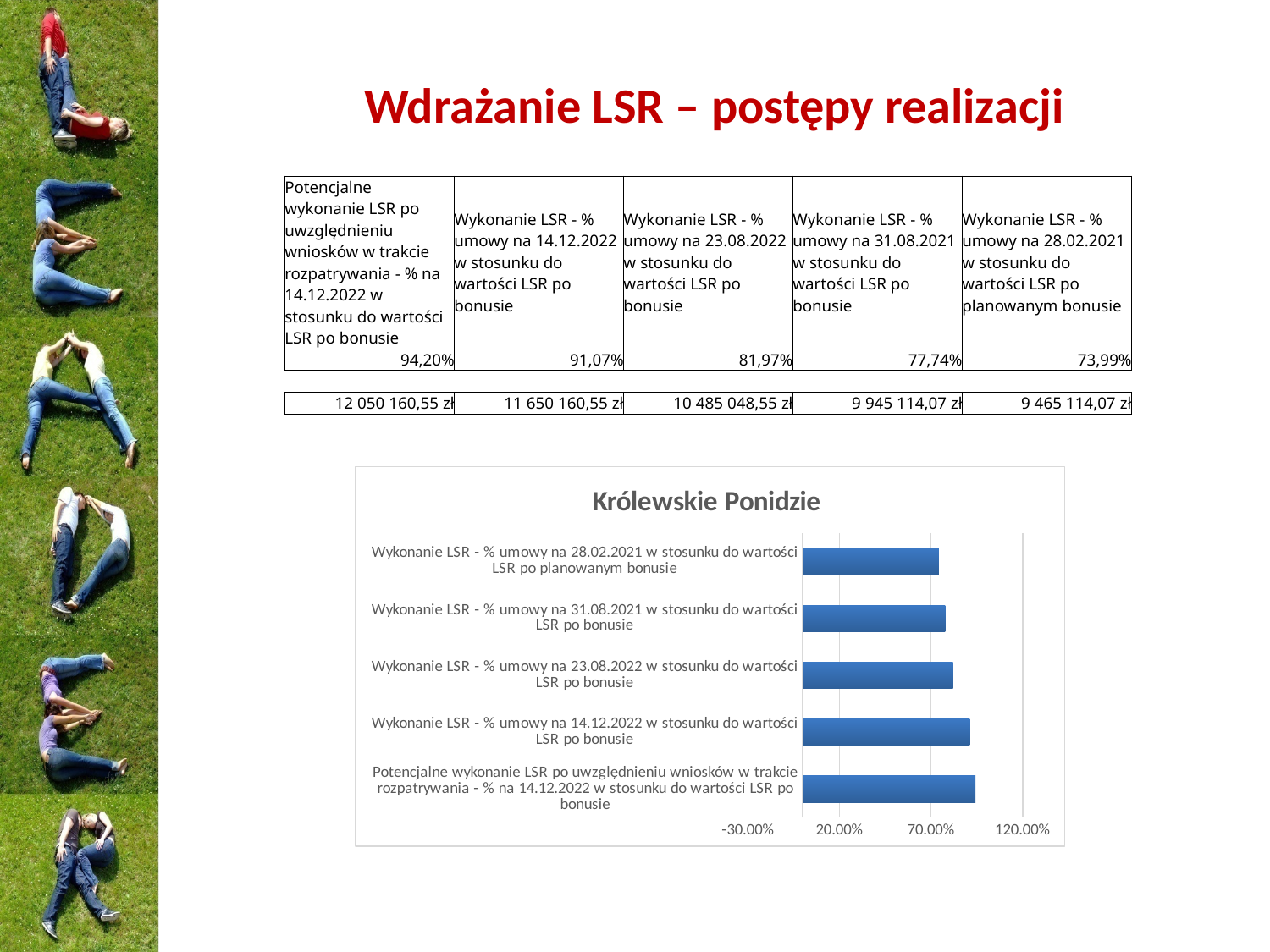
How many categories (bars) does the "Królewskie Ponidzie" chart show? 5 In the "Królewskie Ponidzie" chart, is the value for "Potencjalne wykonanie LSR po uwzględnieniu wniosków w trakcie rozpatrywania" greater or less than 120.00%? less In the "Królewskie Ponidzie" chart, is the value for "Wykonanie LSR - % umowy na 31.08.2021 w stosunku do wartości LSR po bonusie" greater or less than 20.00%? greater What is the title of the chart on the slide? Królewskie Ponidzie In the "Królewskie Ponidzie" chart, is the value for "Wykonanie LSR - % umowy na 14.12.2022 w stosunku do wartości LSR po bonusie" greater or less than 70.00%? greater Which category has the longest bar in the "Królewskie Ponidzie" chart? Potencjalne wykonanie LSR po uwzględnieniu wniosków w trakcie rozpatrywania - % na 14.12.2022 w stosunku do wartości LSR po bonusie In the "Królewskie Ponidzie" chart, which bar is longer: "Wykonanie LSR - % umowy na 14.12.2022" or "Wykonanie LSR - % umowy na 23.08.2022"? Wykonanie LSR - % umowy na 14.12.2022 w stosunku do wartości LSR po bonusie Which category has the shortest bar in the "Królewskie Ponidzie" chart? Wykonanie LSR - % umowy na 28.02.2021 w stosunku do wartości LSR po planowanym bonusie What colour are the bars in the "Królewskie Ponidzie" chart? blue What kind of chart is shown under the title "Królewskie Ponidzie"? bar chart In the "Królewskie Ponidzie" chart, do the bars get longer or shorter going from the top category to the bottom category? longer